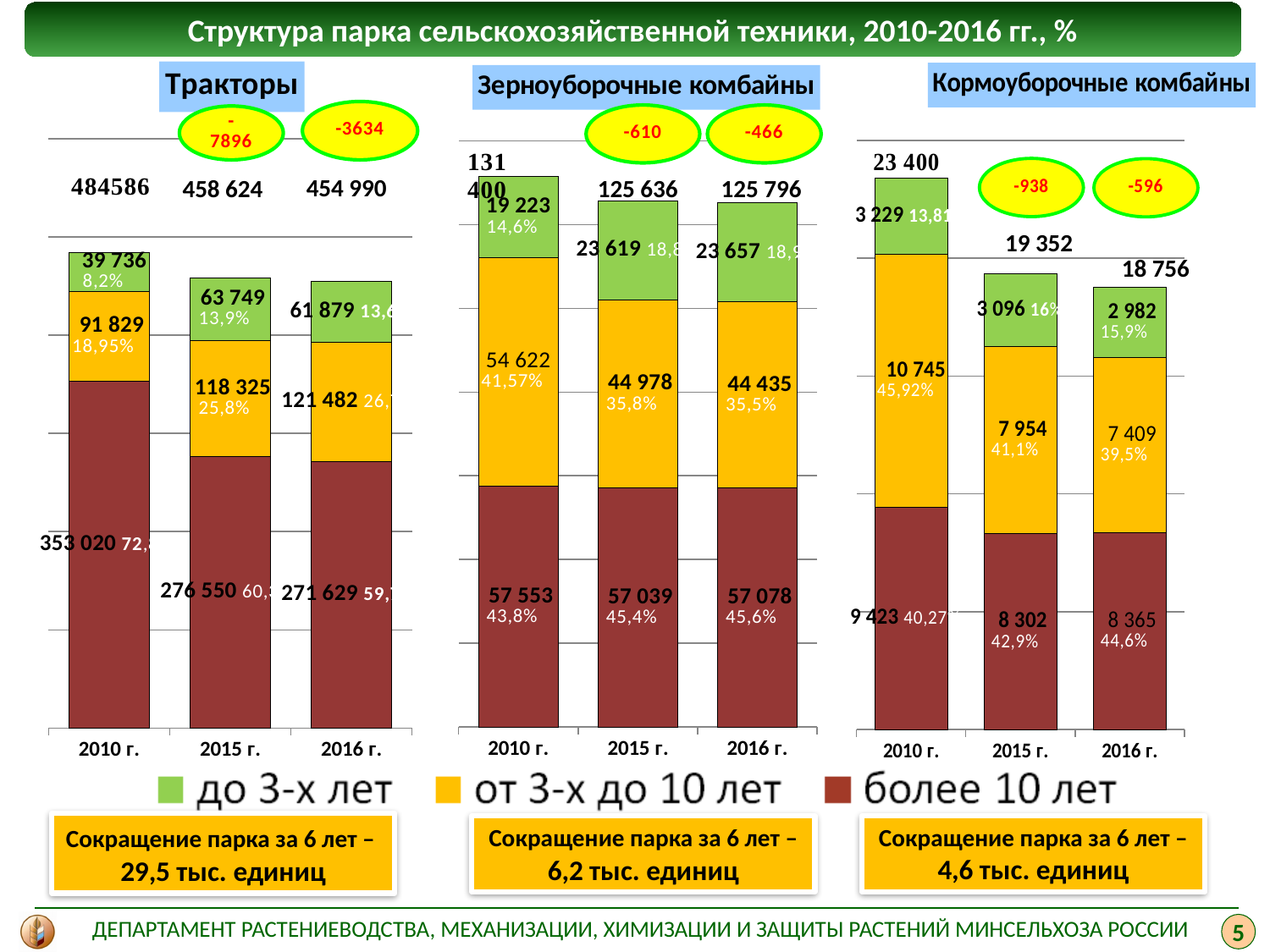
How many series does the shared legend list? 3 On the Тракторы chart, what is the total shown above the 2015 г. bar? 458 624 On the Тракторы chart, what is the value for 'от 3-х до 10 лет' in 2016 г.? 121 482 On the Кормоуборочные комбайны chart, which year has the lowest total shown above the bar? 2016 г. On the Тракторы chart, which is larger: 'до 3-х лет' in 2015 г. or 'до 3-х лет' in 2016 г.? 2015 г. On the Зерноуборочные комбайны chart, what percentage is shown for 'более 10 лет' in 2016 г.? 45,6% On the Кормоуборочные комбайны chart, what is the difference between the 'более 10 лет' values for 2016 г. and 2015 г.? 63 On the Кормоуборочные комбайны chart, what is the value for 'от 3-х до 10 лет' in 2015 г.? 7 954 What type of chart is the Зерноуборочные комбайны chart? Stacked bar chart On the Зерноуборочные комбайны chart, what is the value for 'до 3-х лет' in 2015 г.? 23 619 On the Тракторы chart, what is the value for 'более 10 лет' in 2010 г.? 353 020 On the Зерноуборочные комбайны chart, which year has the highest value for 'от 3-х до 10 лет'? 2010 г.